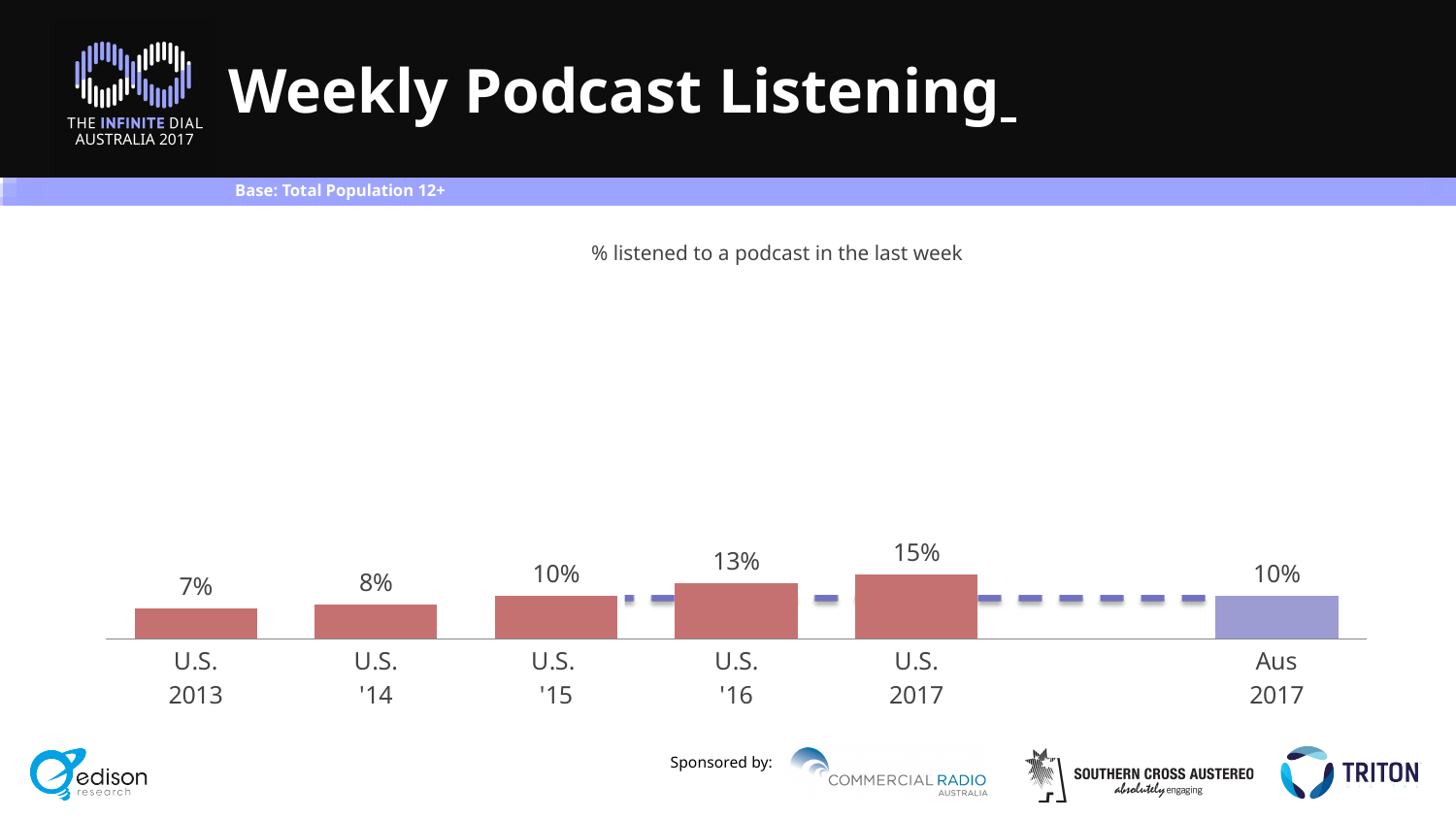
What is the difference between the U.S. 2017 value and the Aus 2017 value? 5% What kind of chart is this? bar chart Which category has the highest value? U.S. 2017 Which is larger, the value for U.S. '15 or the value for U.S. 2017? U.S. 2017 What is the value for Aus 2017? 10% What is the value for U.S. 2017? 15% Which category has the lowest value? U.S. 2013 What is the value for U.S. 2013? 7% What is the difference between the U.S. '16 value and the U.S. '14 value? 5% Do the U.S. values rise or fall from 2013 to 2017? rise How many categories are shown on the chart? 6 What is the value for U.S. '16? 13%